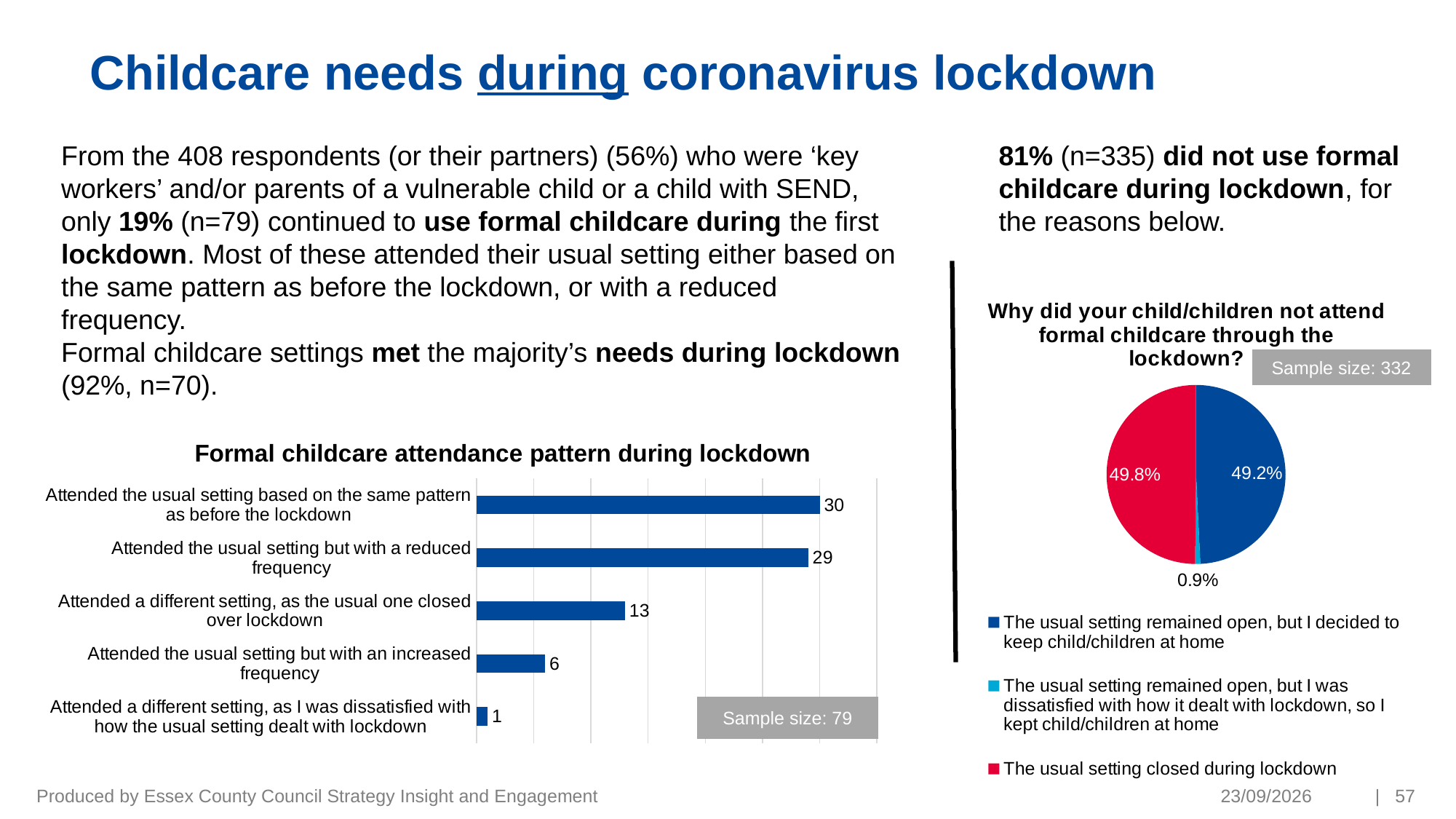
In the 'Formal childcare attendance pattern during lockdown' chart, which is larger: 'Attended a different setting, as the usual one closed over lockdown' or 'Attended the usual setting but with an increased frequency'? Attended a different setting, as the usual one closed over lockdown In the 'Formal childcare attendance pattern during lockdown' chart, what is the difference between 'Attended the usual setting but with a reduced frequency' and 'Attended the usual setting but with an increased frequency'? 23 In the 'Formal childcare attendance pattern during lockdown' chart, how many categories are shown? 5 In the pie chart 'Why did your child/children not attend formal childcare through the lockdown?', what sample size is shown? Sample size: 332 In the pie chart 'Why did your child/children not attend formal childcare through the lockdown?', what share is 'The usual setting remained open, but I was dissatisfied with how it dealt with lockdown, so I kept child/children at home'? 0.9% What type of chart is 'Formal childcare attendance pattern during lockdown'? Bar chart In the 'Formal childcare attendance pattern during lockdown' chart, what is the value for 'Attended a different setting, as the usual one closed over lockdown'? 13 In the 'Formal childcare attendance pattern during lockdown' chart, what is the value for 'Attended the usual setting based on the same pattern as before the lockdown'? 30 In the pie chart 'Why did your child/children not attend formal childcare through the lockdown?', how many entries does the legend list? 3 In the 'Formal childcare attendance pattern during lockdown' chart, which category has the highest value? Attended the usual setting based on the same pattern as before the lockdown In the 'Formal childcare attendance pattern during lockdown' chart, which category has the lowest value? Attended a different setting, as I was dissatisfied with how the usual setting dealt with lockdown In the pie chart 'Why did your child/children not attend formal childcare through the lockdown?', what share is 'The usual setting closed during lockdown'? 49.8%